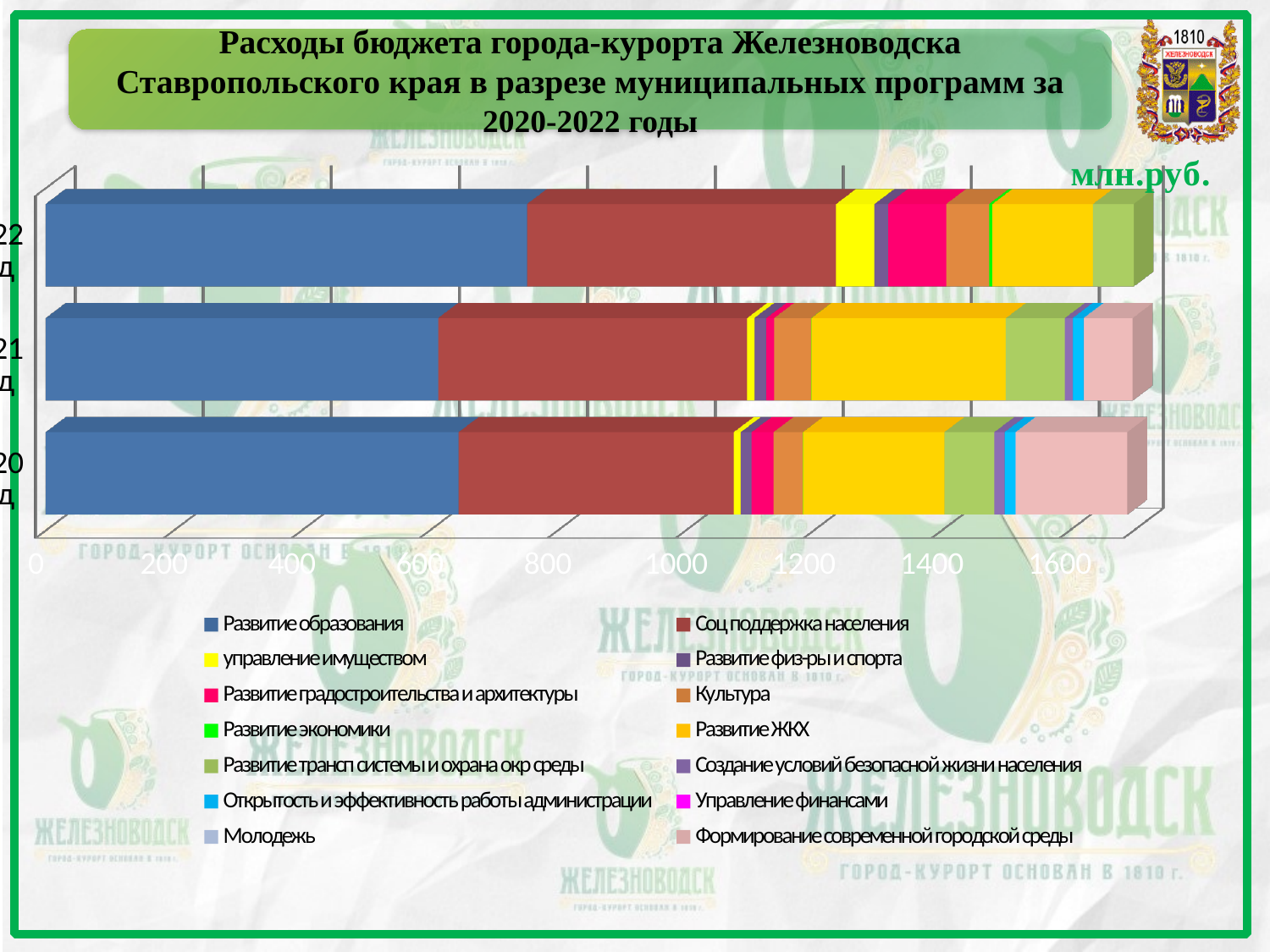
What unit of measurement is indicated on the chart? млн.руб. How many bars (years) does the chart show? 3 Is the value for Соц поддержка населения in the 2022 bar greater or less than 600? less In which year is the Развитие ЖКХ segment the largest? 2021 Is the value for Развитие образования in the 2022 bar greater or less than 600? greater Is the total of the 2022 bar greater or less than 1600? greater What kind of chart is shown on the slide? Stacked bar chart What is the highest value shown on the horizontal axis? 1600 How many series does the legend list? 14 In the 2022 bar, which segment is larger: Развитие образования or Соц поддержка населения? Развитие образования In which year is the Развитие образования segment the largest? 2022